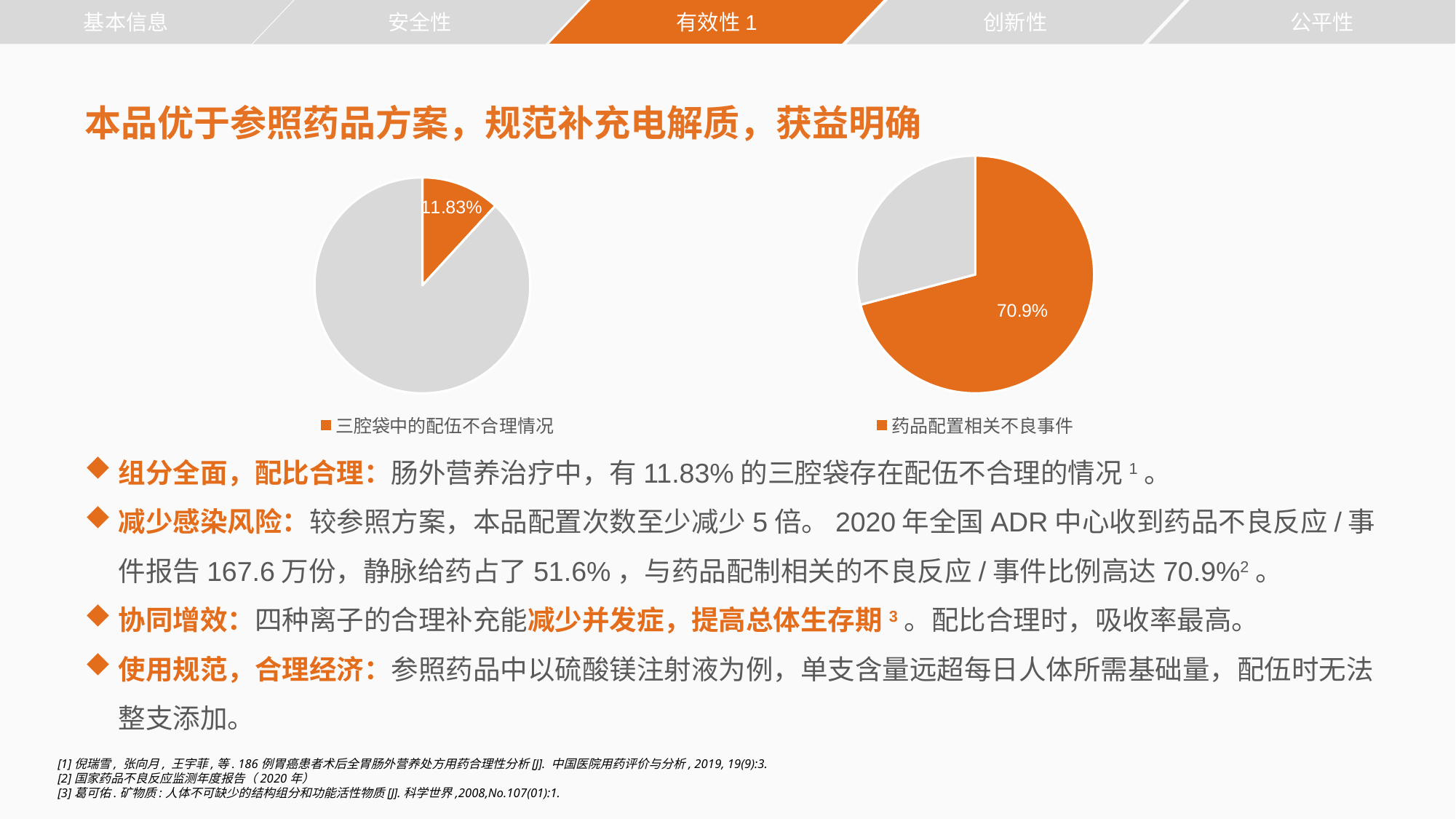
In the right pie chart, what percentage is shown for 药品配置相关不良事件? 70.9% How many slices does the right pie chart have? 2 What colour is the labelled slice in the right pie chart? orange In the left pie chart, what percentage is shown for 三腔袋中的配伍不合理情况? 11.83% In the left pie chart, what share of the pie does the orange slice represent? 11.83% What is the difference between the labelled value in the right pie chart (70.9%) and the labelled value in the left pie chart (11.83%)? 59.07% In the right pie chart, what share of the pie does the orange slice represent? 70.9% What kind of chart is the right chart on the slide? pie chart Which is larger: the labelled slice in the left pie chart (三腔袋中的配伍不合理情况) or the labelled slice in the right pie chart (药品配置相关不良事件)? 药品配置相关不良事件 What legend entry is shown below the left pie chart? 三腔袋中的配伍不合理情况 How many slices does the left pie chart have? 2 What kind of chart is the left chart on the slide? pie chart